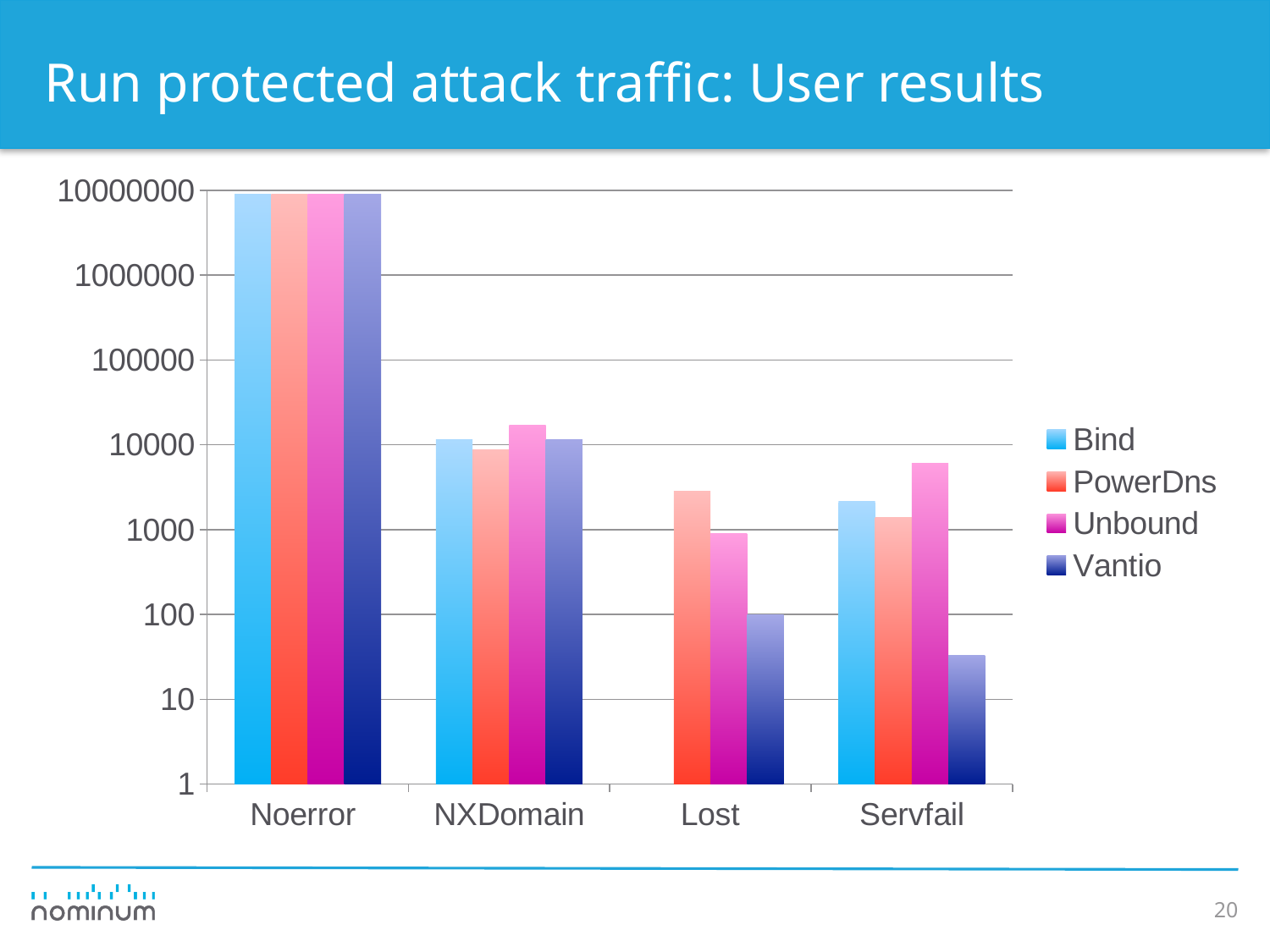
How many categories are shown on the x axis? 4 Which series has the lowest value for Servfail? Vantio Is the value for Vantio in Servfail greater or less than 100? less Is the value for PowerDns in Lost greater or less than 1000? greater Which series has the highest value for NXDomain? Unbound How many series does the legend list? 4 Which series has the highest value for Servfail? Unbound Is the value for Unbound in NXDomain greater or less than 10000? greater What is the title of the slide containing the chart? Run protected attack traffic: User results For Lost, which is larger: PowerDns or Unbound? PowerDns What kind of chart is shown on the slide? bar chart